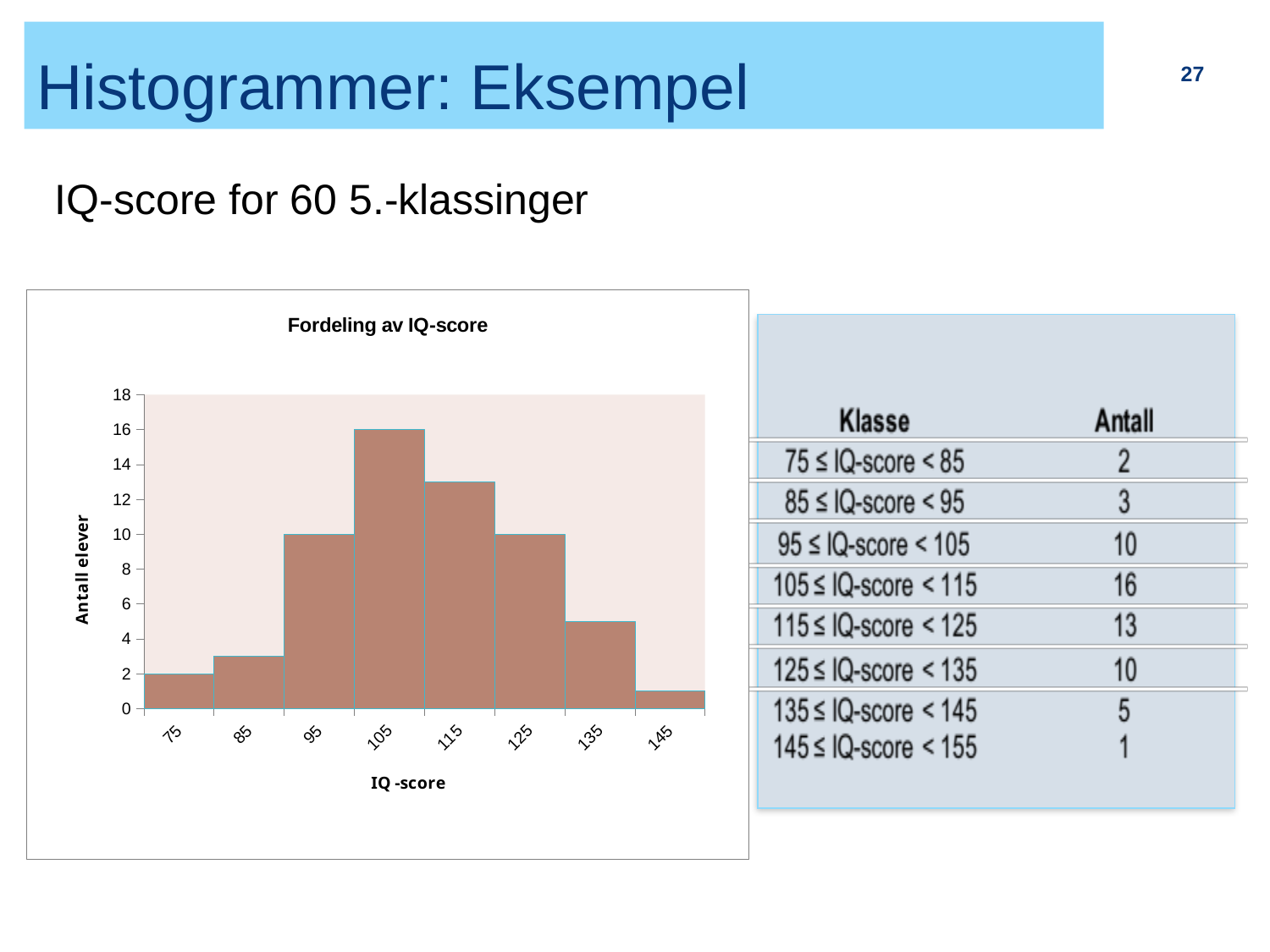
Which IQ-score class has the highest number of pupils? 105 What is the number of pupils for the IQ-score class starting at 115? 13 What is the number of pupils (Antall elever) for the IQ-score class starting at 105? 16 Which has more pupils: the class starting at 95 or the class starting at 135? 95 What is the label of the y-axis? Antall elever What is the difference in number of pupils between the class starting at 105 and the class starting at 115? 3 Which IQ-score class has the lowest number of pupils? 145 What is the title of the chart? Fordeling av IQ-score Is the number of pupils for the class starting at 125 greater or less than 8? greater How many bars (IQ-score classes) are shown in the chart? 8 What is the number of pupils for the IQ-score class starting at 75? 2 What type of chart is shown on the slide? bar chart (histogram)